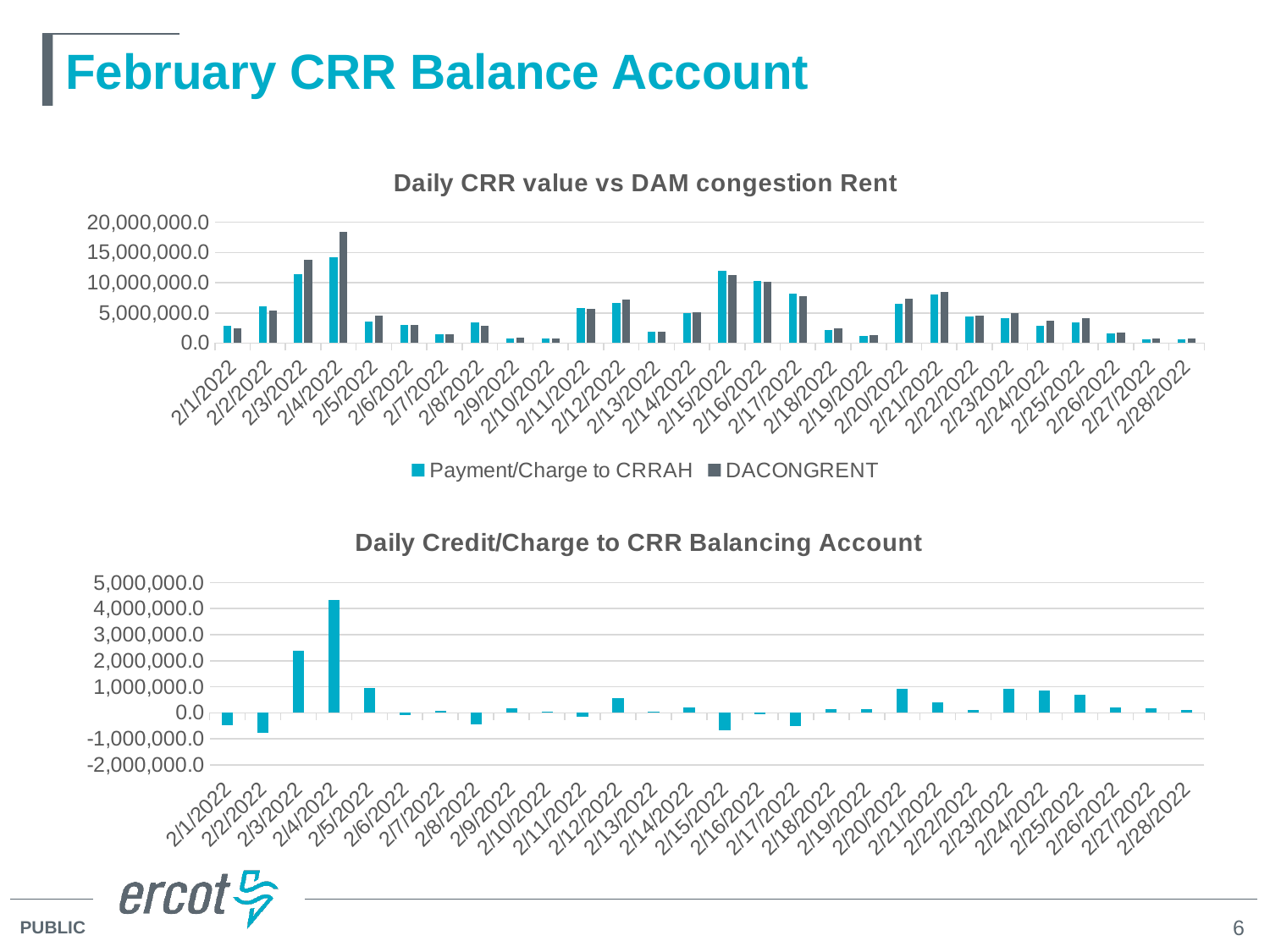
In the top chart 'Daily CRR value vs DAM congestion Rent', which is larger on 2/4/2022: Payment/Charge to CRRAH or DACONGRENT? DACONGRENT What kind of chart is the top chart titled 'Daily CRR value vs DAM congestion Rent'? bar chart In the bottom chart 'Daily Credit/Charge to CRR Balancing Account', is the value for 2/4/2022 greater or less than 4,000,000.0? greater In the top chart 'Daily CRR value vs DAM congestion Rent', how many dates are shown on the x axis? 28 In the top chart 'Daily CRR value vs DAM congestion Rent', what are the two series named in the legend? Payment/Charge to CRRAH and DACONGRENT What is the title of the bottom chart on the slide? Daily Credit/Charge to CRR Balancing Account In the bottom chart 'Daily Credit/Charge to CRR Balancing Account', on which date is the value highest? 2/4/2022 In the top chart 'Daily CRR value vs DAM congestion Rent', on which date is DACONGRENT highest? 2/4/2022 In the top chart 'Daily CRR value vs DAM congestion Rent', is the Payment/Charge to CRRAH value for 2/3/2022 greater or less than 10,000,000.0? greater In the bottom chart 'Daily Credit/Charge to CRR Balancing Account', which date has the larger value: 2/3/2022 or 2/4/2022? 2/4/2022 In the top chart 'Daily CRR value vs DAM congestion Rent', is the DACONGRENT value for 2/4/2022 greater or less than 15,000,000.0? greater How many series does the legend of the top chart 'Daily CRR value vs DAM congestion Rent' list? 2